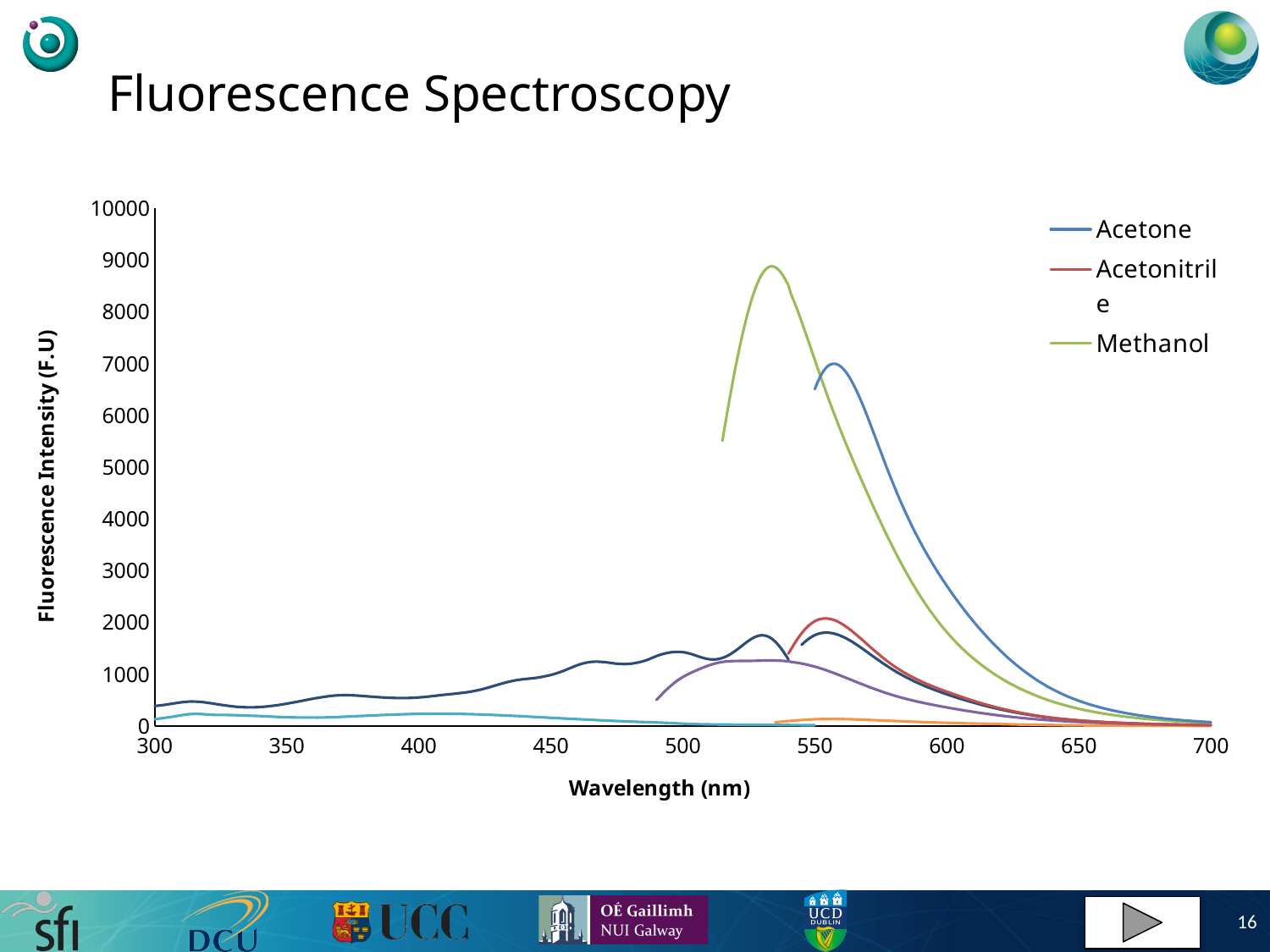
Which has a higher peak fluorescence intensity, Methanol or Acetone? Methanol Is the peak value for Acetone greater or less than 8000? less How many series does the chart legend list? 3 Which has a higher peak fluorescence intensity, Acetonitrile or Acetone? Acetone What colour is the Methanol line in the legend? green Is the peak value for Methanol greater or less than 8000? greater Which series reaches the highest fluorescence intensity? Methanol Does the Acetone curve rise or fall between 600 nm and 700 nm? fall What kind of chart is shown on the slide? line chart Is the peak value for Acetone greater or less than 6000? greater What is the label of the x axis? Wavelength (nm)